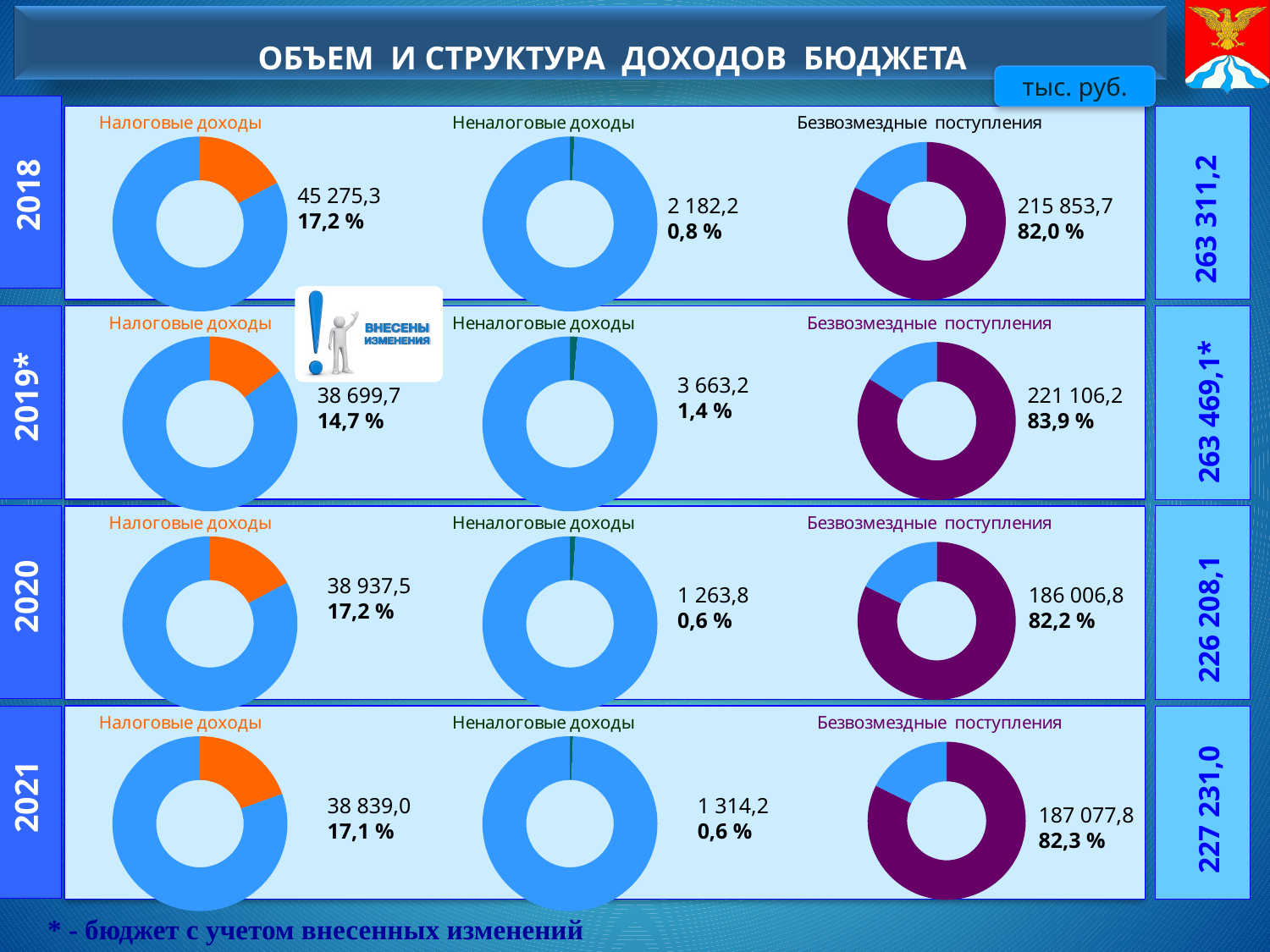
In the 2018 row, what value is shown on the 'Налоговые доходы' donut chart? 45 275,3 Across the four 'Налоговые доходы' donut charts, which year shows the lowest value? 2019* In the 2019* row, what value is shown on the 'Неналоговые доходы' donut chart? 3 663,2 What type of chart is used to show the income structure on this slide? Donut (pie) chart Which is larger: the 'Безвозмездные поступления' value for 2019* or for 2020? 2019* In the 2021 row, what value is shown on the 'Безвозмездные поступления' donut chart? 187 077,8 In the 2020 row, what percentage share is shown on the 'Налоговые доходы' donut chart? 17,2 % How many donut charts are shown on the slide in total? 12 In the 2021 row, what percentage share is shown on the 'Неналоговые доходы' donut chart? 0,6 % In the 2018 row, what percentage share is shown on the 'Безвозмездные поступления' donut chart? 82,0 % Across the four 'Неналоговые доходы' donut charts, which year shows the highest value? 2019* What is the difference between the 'Налоговые доходы' values for 2020 and 2021? 98,5